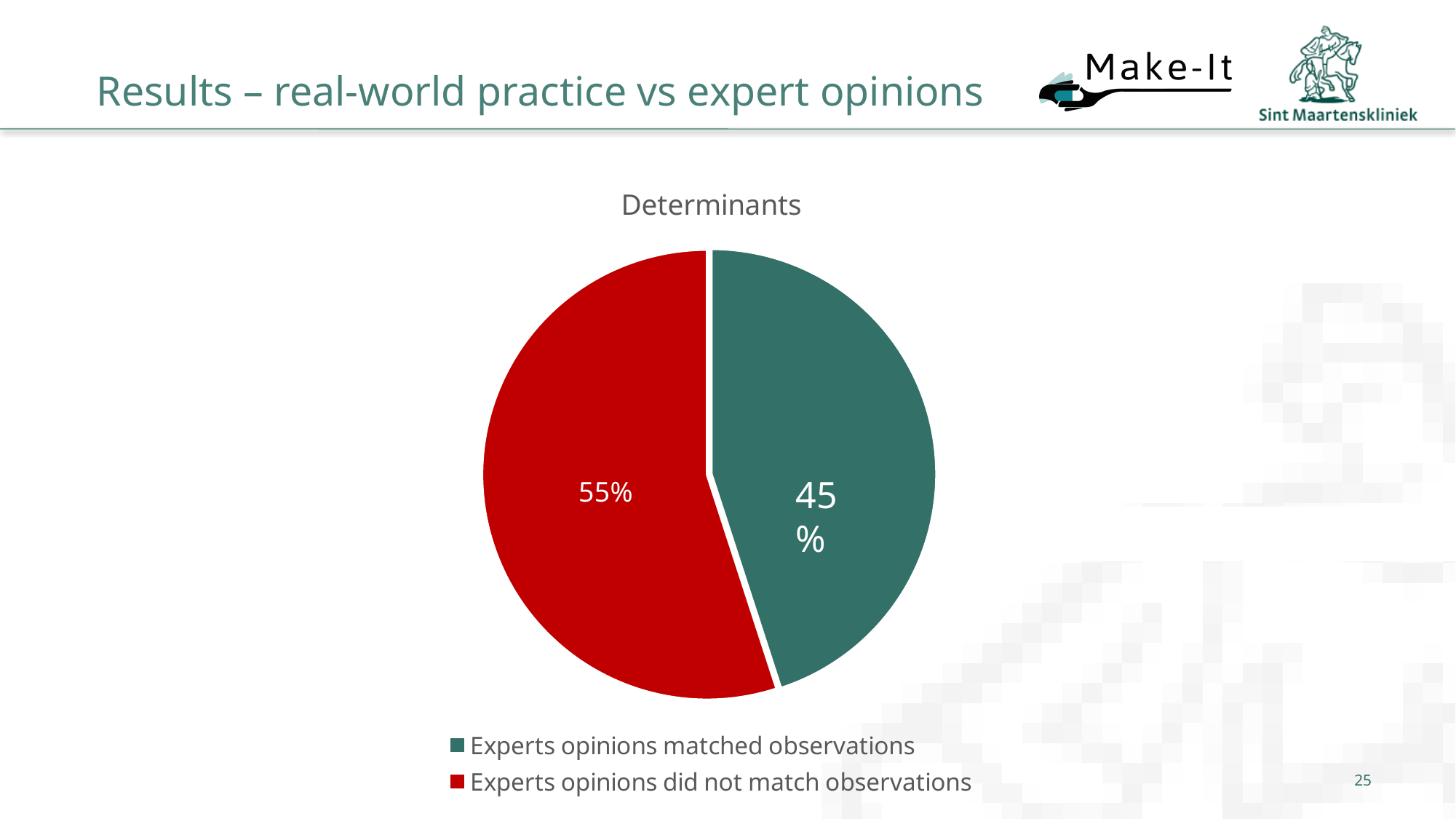
What is the difference in percentage points between the 'did not match' slice and the 'matched' slice? 10 What percentage of the pie is labelled 'Experts opinions matched observations'? 45% What type of chart is shown on the slide? Pie chart What is the title of the chart? Determinants Which slice is the smallest in the pie chart? Experts opinions matched observations What percentage of the pie is labelled 'Experts opinions did not match observations'? 55% How many entries does the legend list? 2 Which slice is the largest in the pie chart? Experts opinions did not match observations What colour is the slice for 'Experts opinions did not match observations'? Red What share of the pie does the 'Experts opinions matched observations' slice represent? 45% How many slices does the pie chart have? 2 Which is larger: the share for 'Experts opinions matched observations' or 'Experts opinions did not match observations'? Experts opinions did not match observations